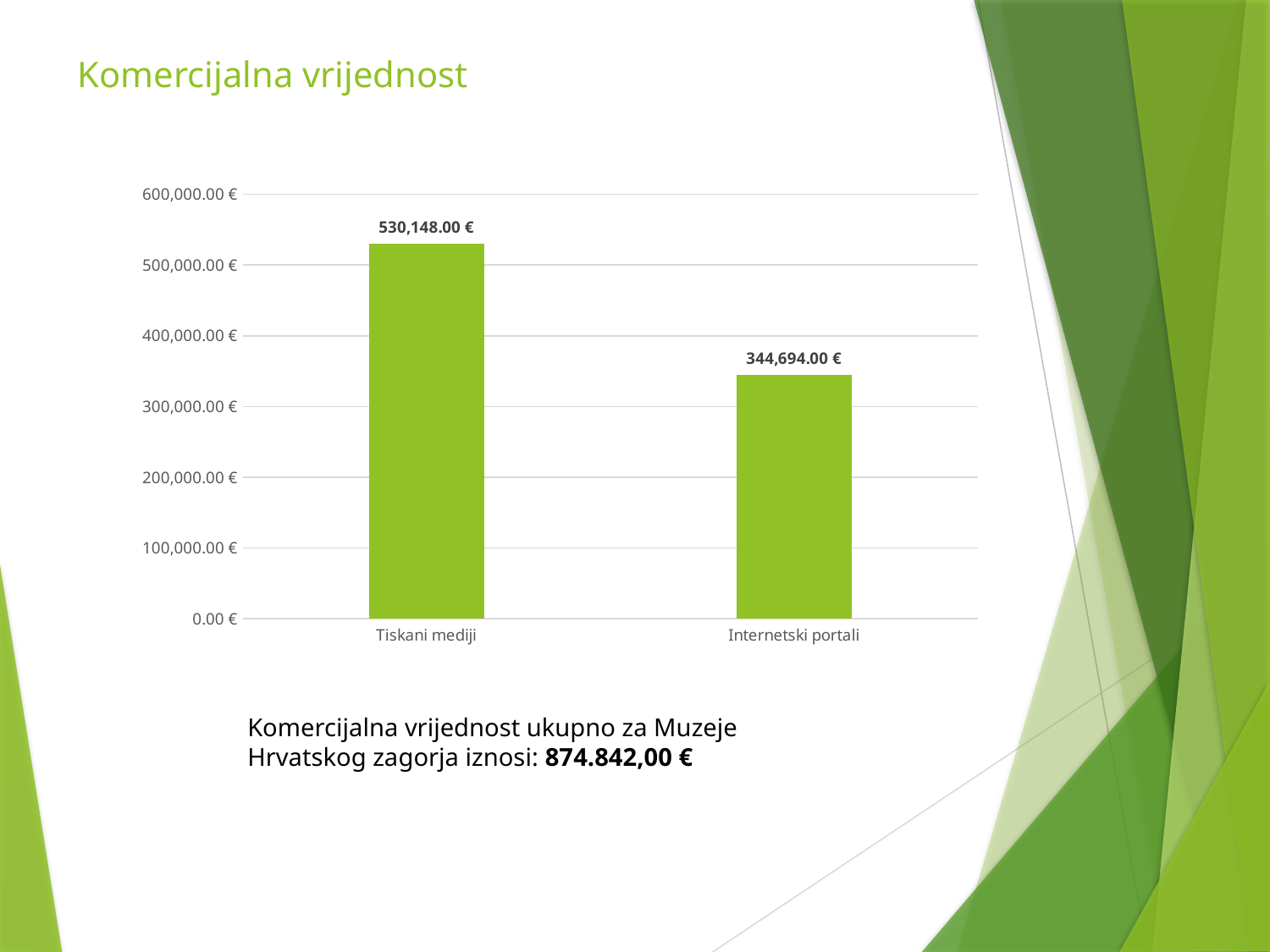
Is the value for Internetski portali greater or less than 400,000.00 €? less Is the value for Tiskani mediji greater or less than 500,000.00 €? greater What is the difference between the values for Tiskani mediji and Internetski portali? 185,454.00 € Which is larger, the value for Tiskani mediji or the value for Internetski portali? Tiskani mediji What is the value for Internetski portali? 344,694.00 € What is the sum of the two values plotted in the chart? 874,842.00 € What is the highest value shown on the y axis of the chart? 600,000.00 € What is the value for Tiskani mediji? 530,148.00 € Which category has the highest value? Tiskani mediji How many categories are shown on the x axis of the chart? 2 What kind of chart is shown on the slide? bar chart Which category has the lowest value? Internetski portali